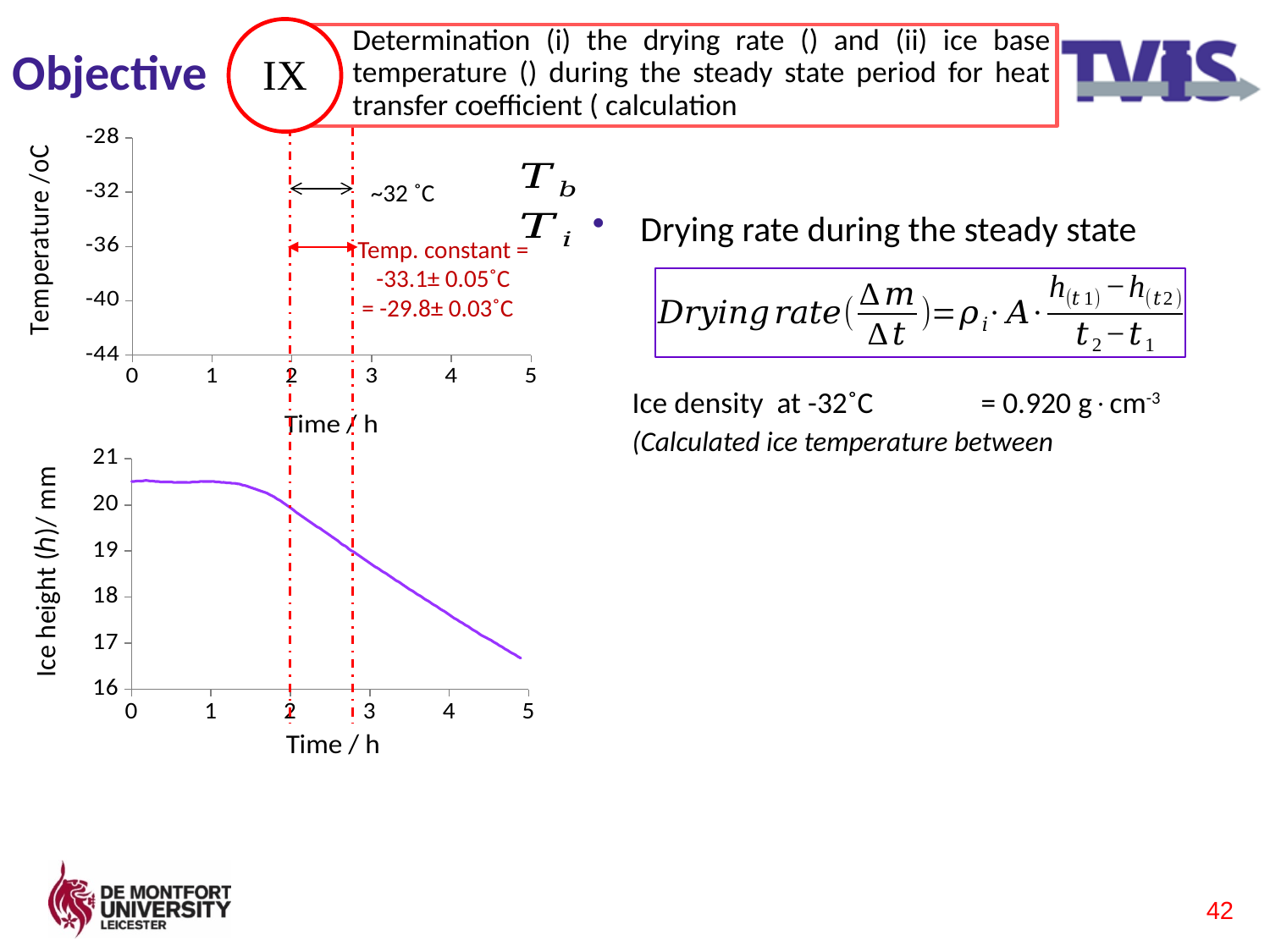
In the bottom chart, is the ice height at 4 h greater or less than 17 mm? greater What is the label of the y-axis on the bottom chart? Ice height (h)/ mm In the bottom chart, what is the highest value shown on the ice height axis? 21 In the bottom chart, is the ice height larger at 1 h or at 4 h? 1 h In the bottom chart, does the ice height rise or fall as time increases from 2 h to 5 h? fall In the bottom chart, is the ice height at 3 h greater or less than 20 mm? less In the top chart, what is the lowest value shown on the temperature axis? -44 In the bottom chart, is the ice height at 1 h greater or less than 20 mm? greater What kind of chart is the bottom chart showing ice height against time? line chart What is the label of the y-axis on the top chart? Temperature /oC